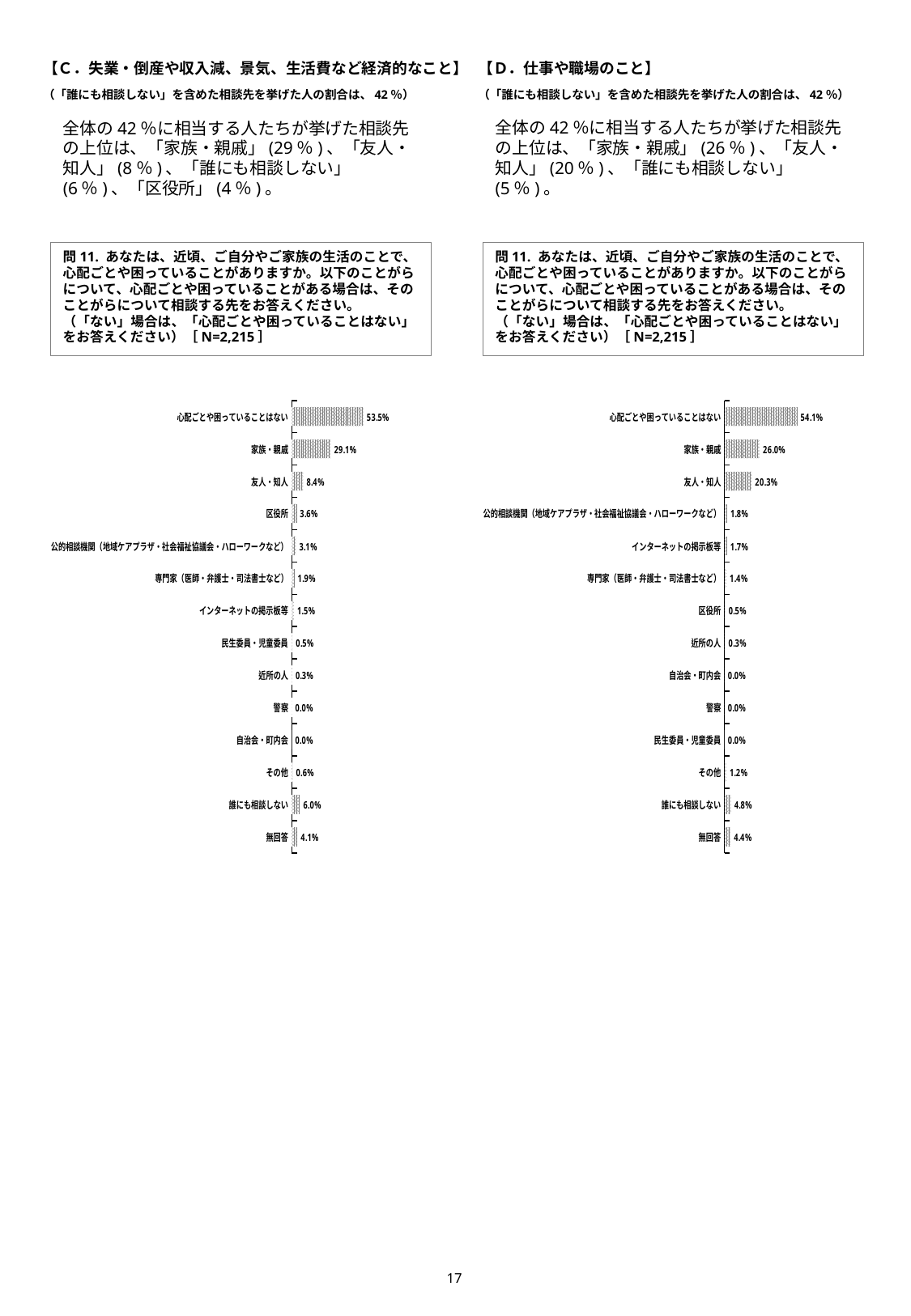
In the left chart (C. 失業・倒産や収入減、景気、生活費など経済的なこと), what is the value for 家族・親戚? 29.1% In the right chart (D. 仕事や職場のこと), which is larger, 誰にも相談しない or 無回答? 誰にも相談しない In the right chart (D. 仕事や職場のこと), what is the value for 無回答? 4.4% In the left chart (C. 失業・倒産や収入減、景気、生活費など経済的なこと), which is larger, 区役所 or 公的相談機関（地域ケアプラザ・社会福祉協議会・ハローワークなど）? 区役所 In the right chart (D. 仕事や職場のこと), what is the value for 友人・知人? 20.3% In the right chart (D. 仕事や職場のこと), what is the difference between 家族・親戚 and 友人・知人? 5.7% In the left chart (C. 失業・倒産や収入減、景気、生活費など経済的なこと), what is the difference between 家族・親戚 and 友人・知人? 20.7% How many categories are shown in the left chart (C. 失業・倒産や収入減、景気、生活費など経済的なこと)? 14 What type of chart is the right chart (D. 仕事や職場のこと)? Bar chart In the left chart (C. 失業・倒産や収入減、景気、生活費など経済的なこと), which category has the highest value? 心配ごとや困っていることはない In the left chart (C. 失業・倒産や収入減、景気、生活費など経済的なこと), what is the value for 誰にも相談しない? 6.0% In the right chart (D. 仕事や職場のこと), which category has the highest value? 心配ごとや困っていることはない